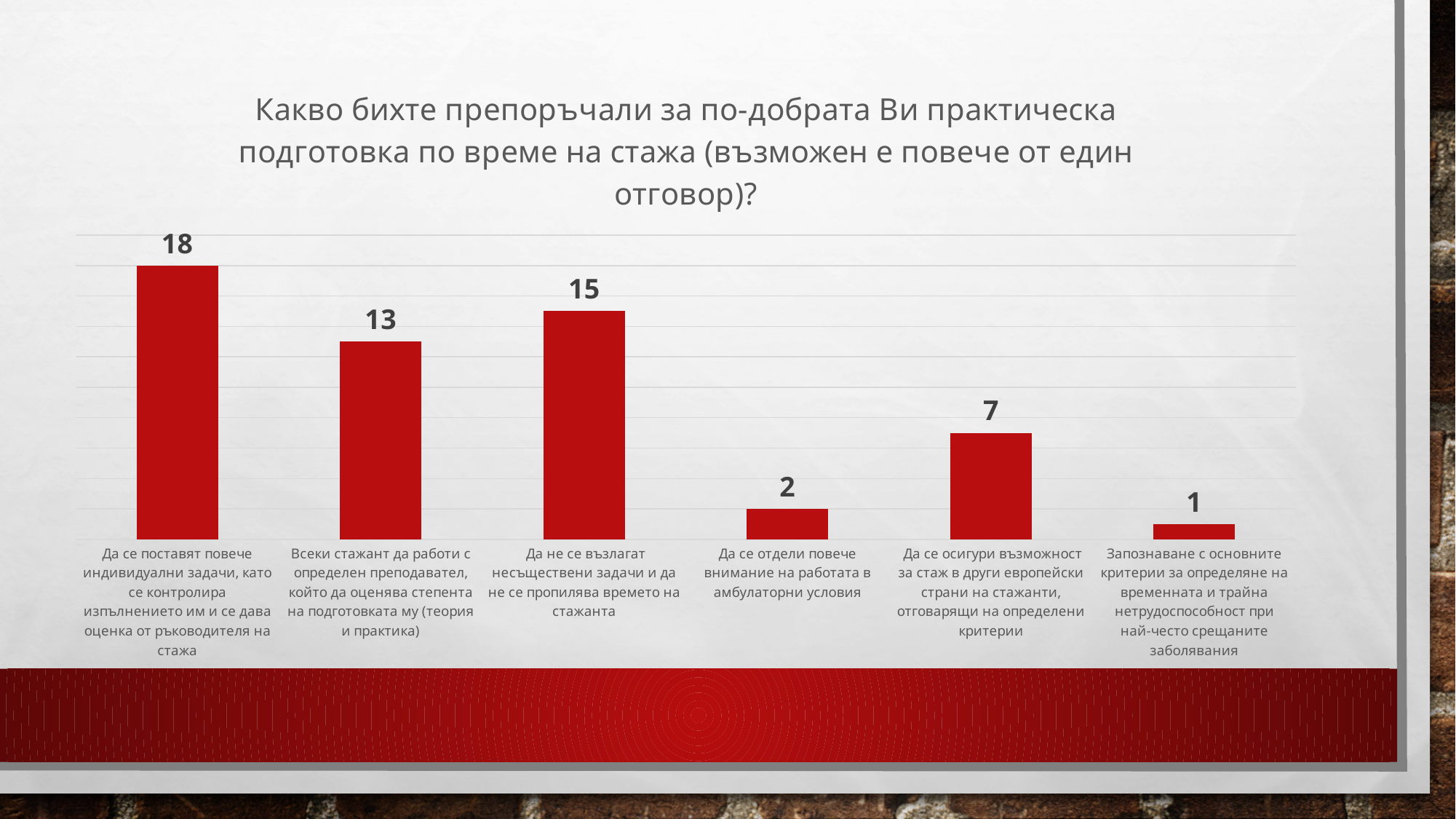
How many categories are shown in the chart? 6 What colour are the bars in the chart? Red What is the value for "Да се отдели повече внимание на работата в амбулаторни условия"? 2 Which category has the lowest value? Запознаване с основните критерии за определяне на временната и трайна нетрудоспособност при най-често срещаните заболявания What kind of chart is shown on the slide? Bar chart Which category has the highest value? Да се поставят повече индивидуални задачи, като се контролира изпълнението им и се дава оценка от ръководителя на стажа What is the difference between the value for "Да се осигури възможност за стаж в други европейски страни..." and the value for "Да се отдели повече внимание на работата в амбулаторни условия"? 5 What is the value for "Всеки стажант да работи с определен преподавател, който да оценява степента на подготовката му (теория и практика)"? 13 What is the value for "Да се осигури възможност за стаж в други европейски страни на стажанти, отговарящи на определени критерии"? 7 What is the total of all the values shown in the chart? 56 Which is larger: the value for "Всеки стажант да работи с определен преподавател..." or the value for "Да не се възлагат несъществени задачи..."? Да не се възлагат несъществени задачи и да не се пропилява времето на стажанта What is the difference between the value for "Да се поставят повече индивидуални задачи..." and the value for "Да не се възлагат несъществени задачи..."? 3